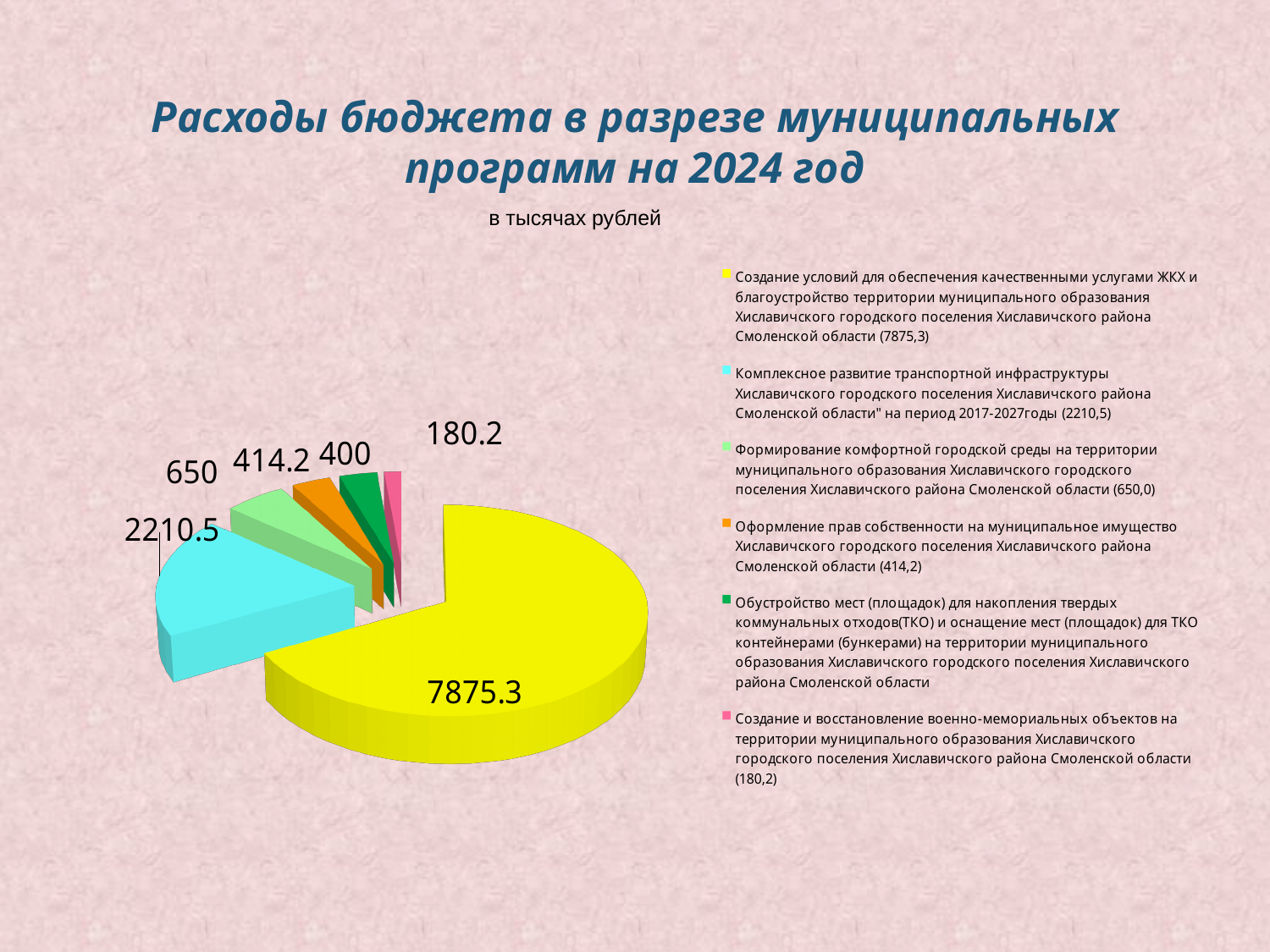
What is the value for the program "Комплексное развитие транспортной инфраструктуры" (light blue slice)? 2210.5 Which program has the smallest slice of the pie? Создание и восстановление военно-мемориальных объектов What is the value for the program "Обустройство мест (площадок) для накопления твердых коммунальных отходов (ТКО)" (dark green slice)? 400 What is the value for the program "Формирование комфортной городской среды" (light green slice)? 650 What is the value for the program "Создание условий для обеспечения качественными услугами ЖКХ и благоустройство территории" (yellow slice)? 7875.3 What share of the pie does the largest slice (7875.3) represent? 67.1% What is the difference between the values for "Комплексное развитие транспортной инфраструктуры" and "Формирование комфортной городской среды"? 1560.5 Which is larger: the value for "Оформление прав собственности на муниципальное имущество" or the value for "Обустройство мест (площадок) для накопления ТКО"? Оформление прав собственности на муниципальное имущество What kind of chart is shown on the slide? pie chart How many slices does the pie chart have? 6 In what units are the values on the chart expressed, according to the subtitle? в тысячах рублей Which program has the largest slice of the pie? Создание условий для обеспечения качественными услугами ЖКХ и благоустройство территории